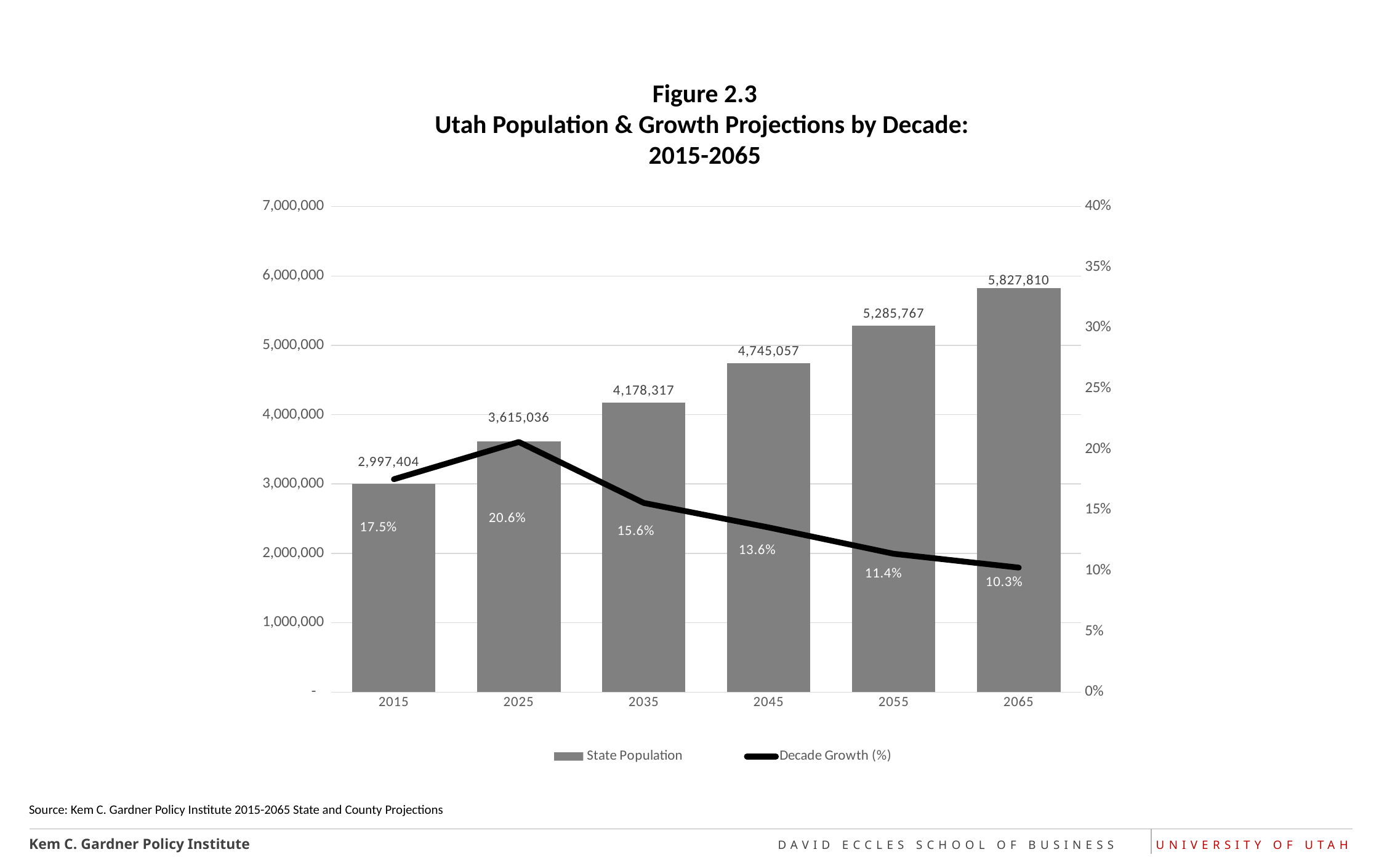
Does the Decade Growth (%) line rise or fall from 2025 to 2065? fall What kind of chart is used to show State Population? bar chart What is the Decade Growth (%) value shown for 2025? 20.6% How many decades (years) are shown on the x axis? 6 Which year has the lowest State Population? 2015 What is the difference in State Population between 2065 and 2055? 542,043 Which year has the highest Decade Growth (%)? 2025 How many series does the legend list? 2 What is the projected State Population for 2045? 4,745,057 What is the State Population value for 2015? 2,997,404 Is the State Population for 2035 greater or less than 4,000,000? greater Which is larger, the Decade Growth (%) for 2035 or for 2045? 2035